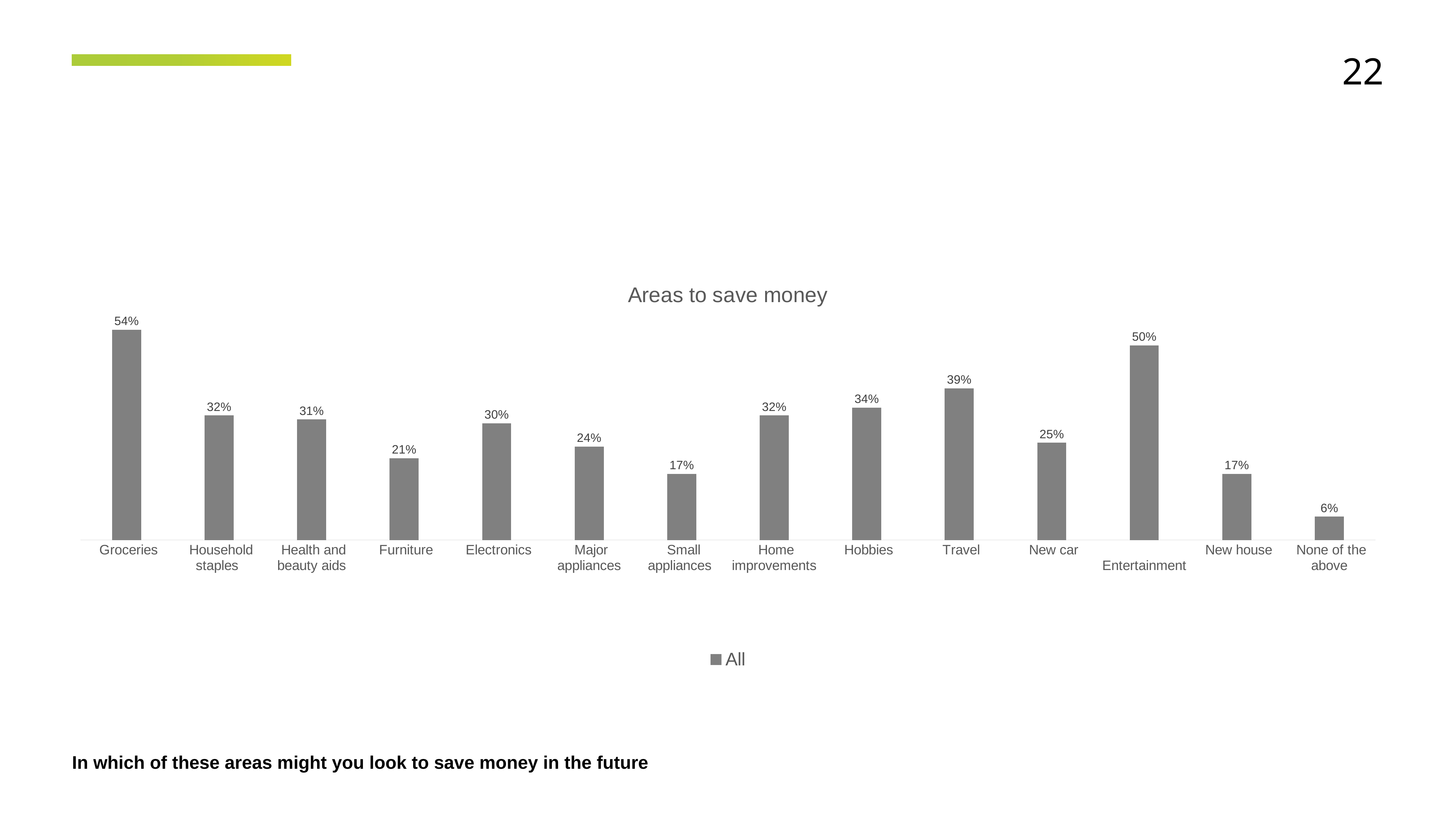
What is the value for Entertainment? 50% Which category has the highest value? Groceries Which is larger, the value for Hobbies or the value for Electronics? Hobbies How many categories are shown on the x axis? 14 What kind of chart is shown? Bar chart What is the title of the chart? Areas to save money What is the value for Groceries? 54% How many series does the legend list? 1 What is the difference between the values for Groceries and Entertainment? 4% What is the value for Furniture? 21% What is the difference between the values for Travel and New car? 14% Which category has the lowest value? None of the above